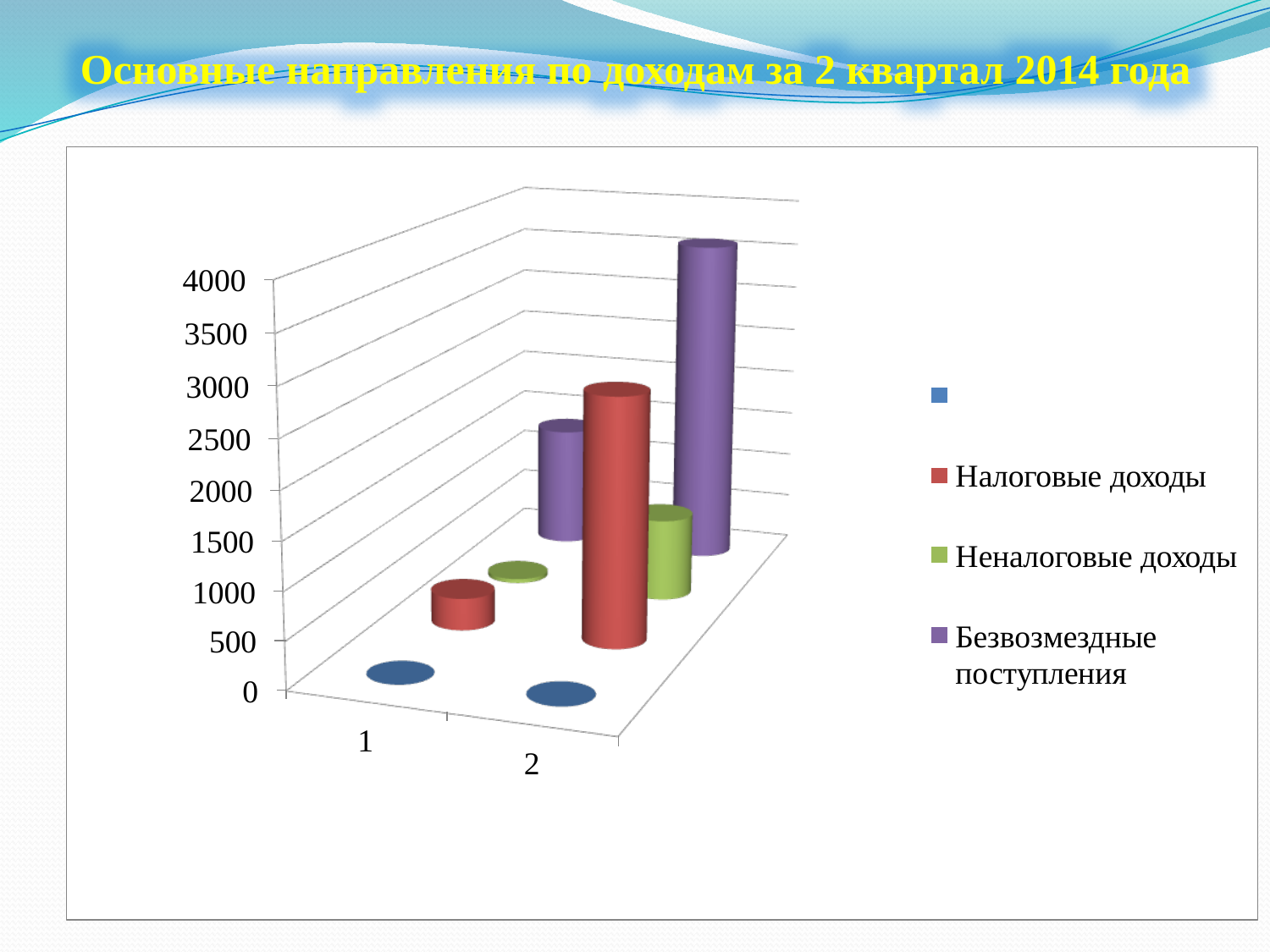
What colour are the bars for Безвозмездные поступления? purple What kind of chart is shown on the slide? bar chart Does the value for Налоговые доходы rise or fall from category 1 to category 2? rise Is the value for Налоговые доходы in category 1 greater or less than 1500? less Is the value for Безвозмездные поступления in category 2 greater or less than 2000? greater How many series with a readable name does the legend list? 3 Is the value for Неналоговые доходы in category 1 greater or less than 1000? less How many categories are shown on the x axis of the chart? 2 Which series has the tallest bar in category 2? Безвозмездные поступления In category 2, which is larger: Налоговые доходы or Неналоговые доходы? Налоговые доходы Which series has the tallest bar in category 1? Безвозмездные поступления